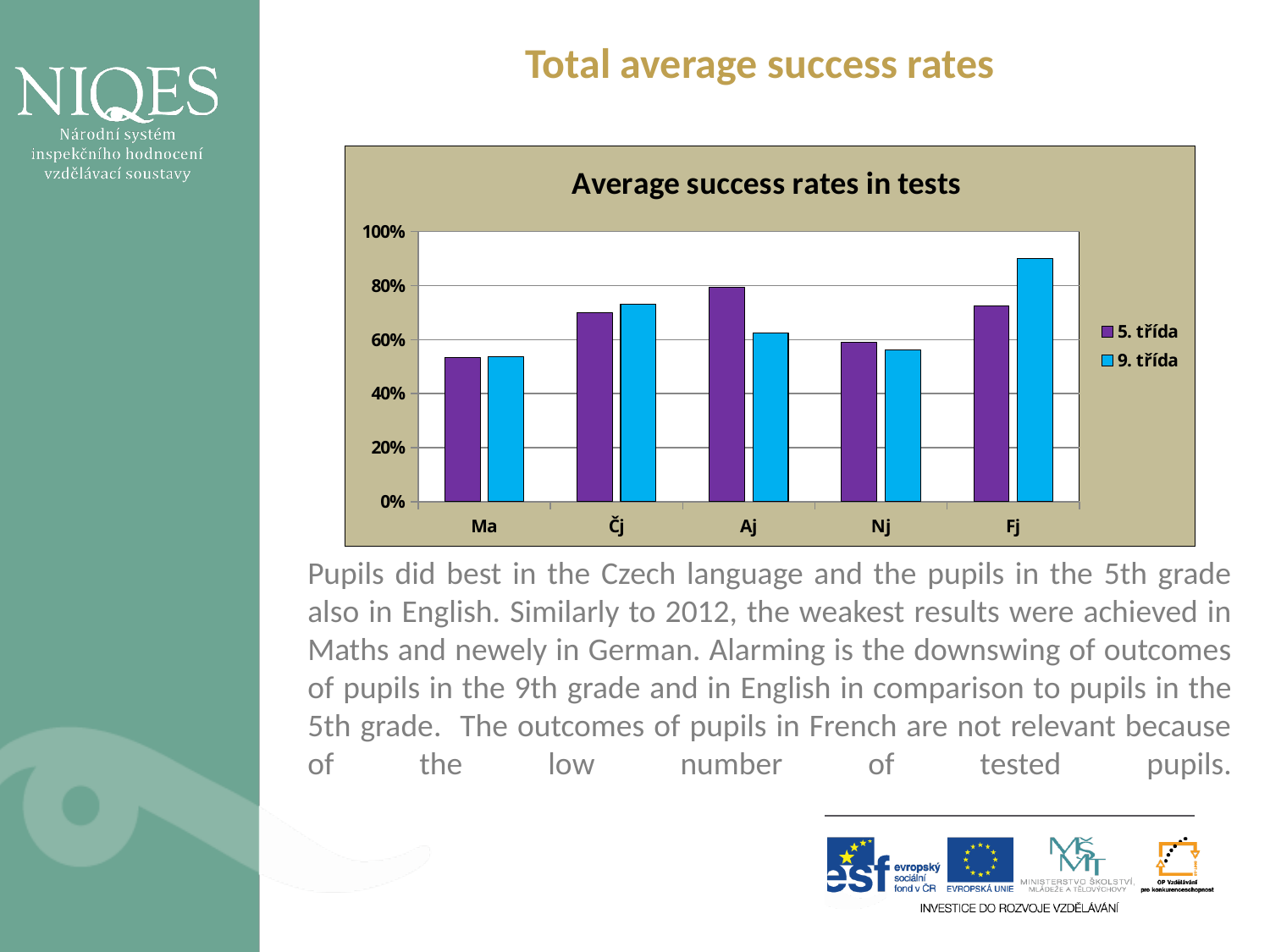
Is the value for 9. třída in Fj greater or less than 80%? greater Which subject has the highest value for 9. třída? Fj Which subject has the lowest value for 5. třída? Ma How many subject categories are shown on the x axis? 5 What is the title of the chart? Average success rates in tests Is the value for 5. třída in Ma greater or less than 60%? less For Fj, which series has the larger value, 5. třída or 9. třída? 9. třída Is the value for 5. třída in Aj greater or less than 60%? greater How many series does the legend list? 2 Which subject has the highest value for 5. třída? Aj For Aj, which series has the larger value, 5. třída or 9. třída? 5. třída What kind of chart is shown on the slide? bar chart